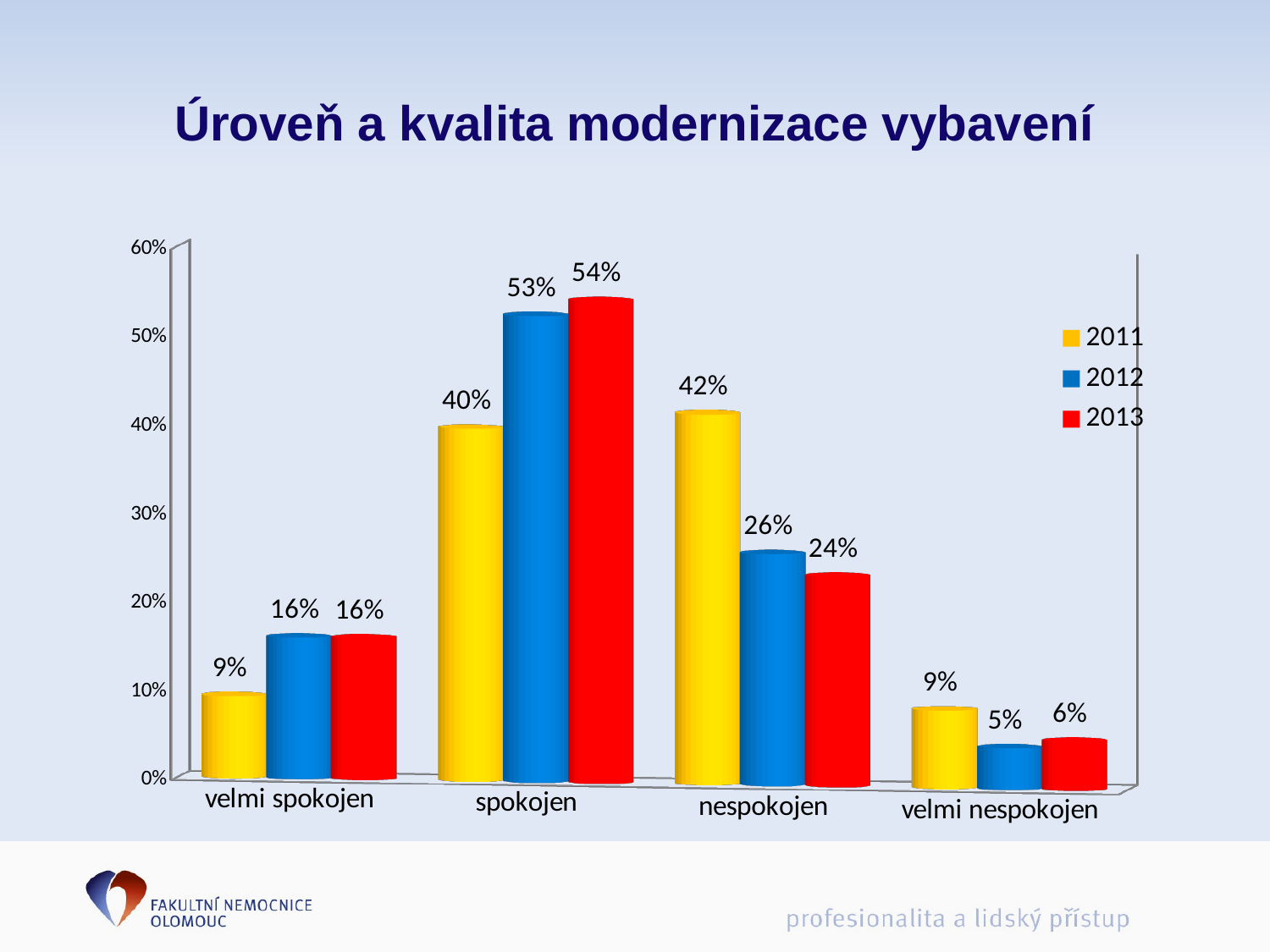
How many categories are shown on the x axis? 4 What is the value for 'spokojen' in 2013? 54% Which is larger for 'spokojen': the 2011 value or the 2012 value? 2012 What is the value for 'velmi nespokojen' in 2012? 5% How many series does the legend list? 3 What is the value for 'velmi spokojen' in 2011? 9% What is the title of the slide? Úroveň a kvalita modernizace vybavení What is the difference between the 2011 and 2013 values for 'nespokojen'? 18% What is the value for 'nespokojen' in 2011? 42% Which category has the highest value for 2012? spokojen Which category has the lowest value for 2013? velmi nespokojen What kind of chart is shown on the slide? bar chart